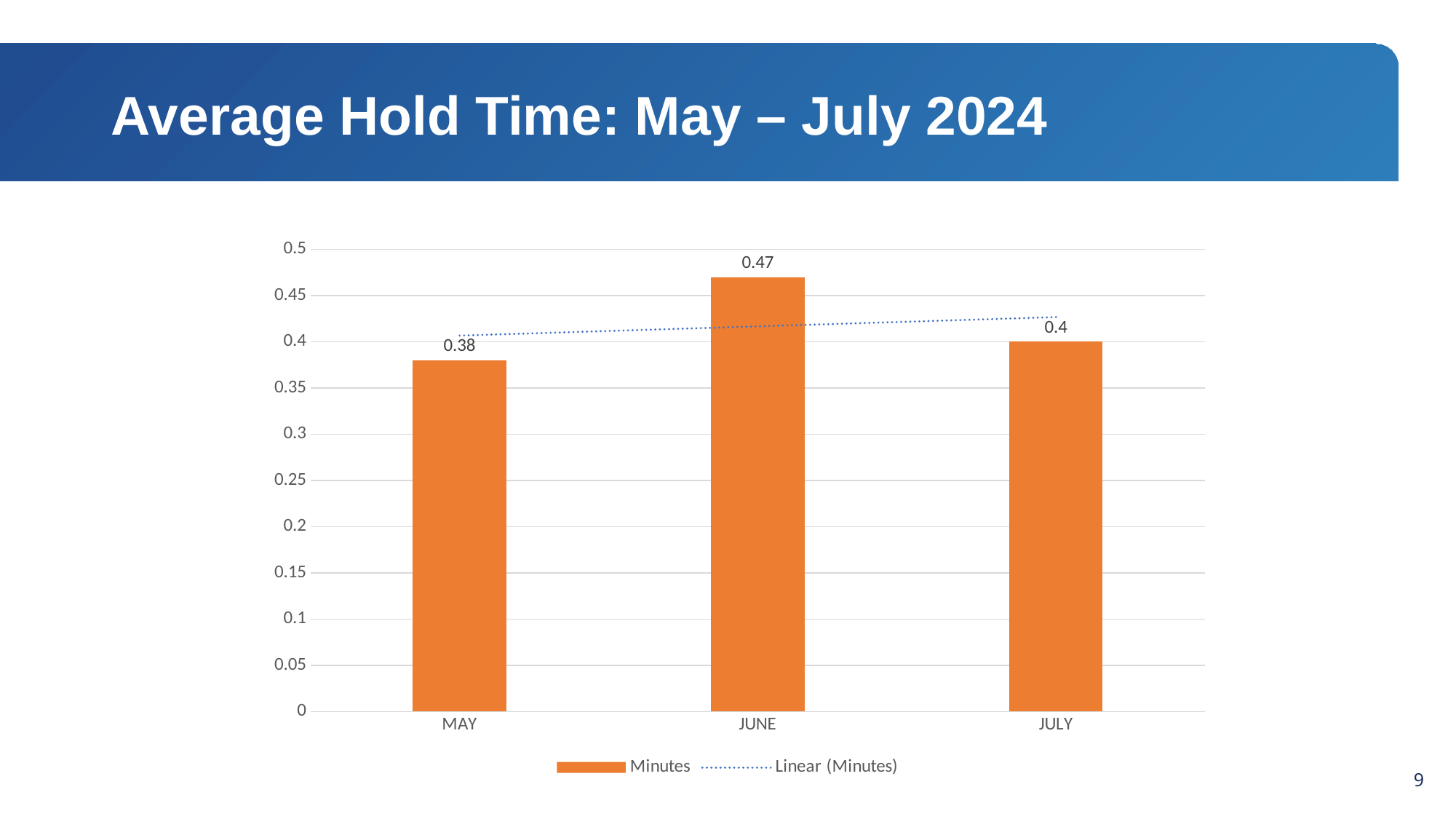
Which month has the lowest value? MAY What is the value for MAY? 0.38 What is the difference between the values for JUNE and JULY? 0.07 How many months are shown on the x axis? 3 Which month has the highest value? JUNE How many entries does the legend list? 2 Is the value for JUNE greater or less than 0.45? greater What kind of chart is shown on the slide? bar chart What is the difference between the values for JUNE and MAY? 0.09 What is the value for JUNE? 0.47 Which is larger, the value for JULY or the value for MAY? JULY What is the value for JULY? 0.4